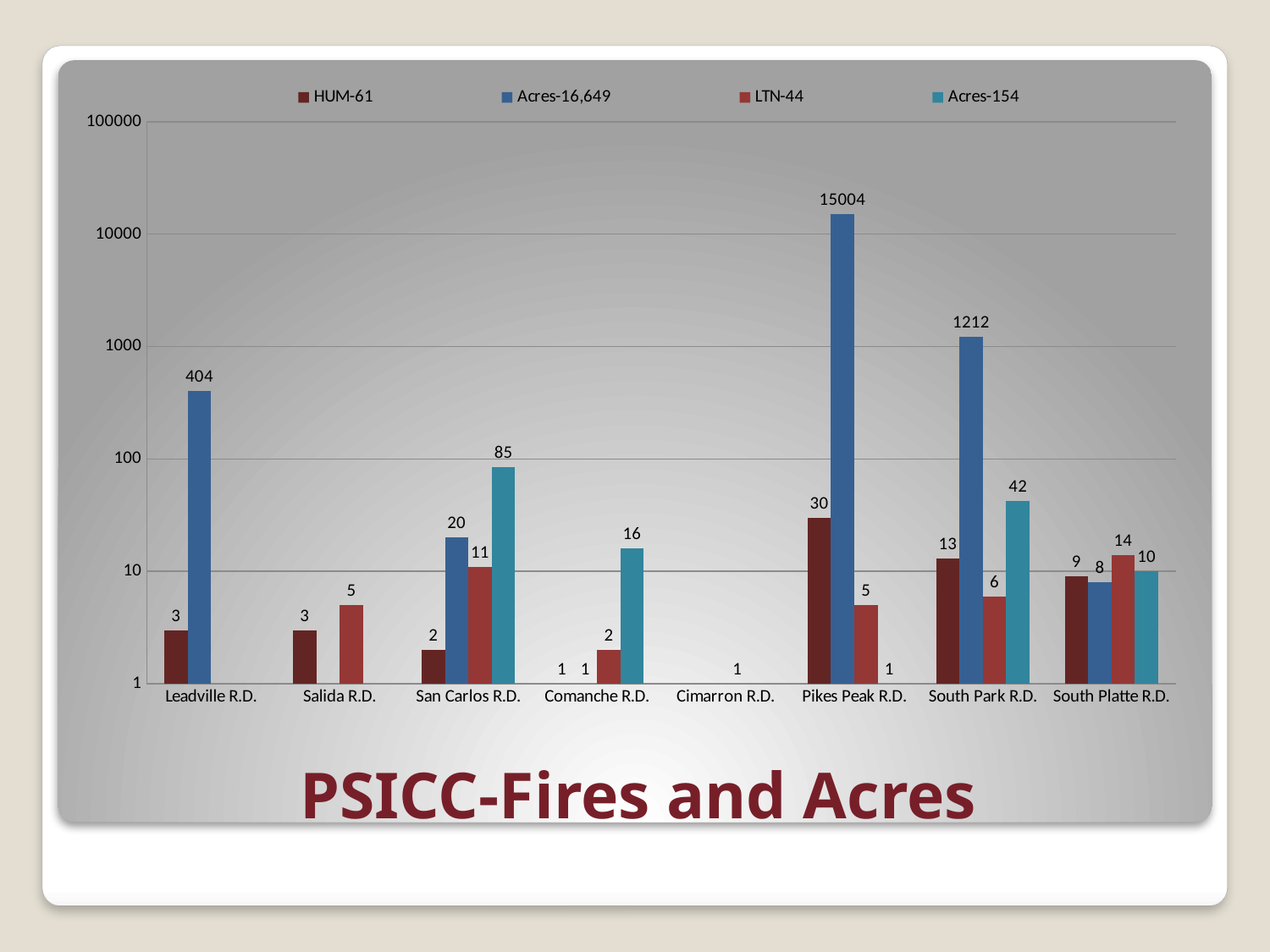
What is the difference between the Acres-154 values for South Park R.D. and Comanche R.D.? 26 What is the value of the Acres-16,649 series for Pikes Peak R.D.? 15004 How many series does the legend list? 4 Which ranger district has the highest HUM-61 value? Pikes Peak R.D. What is the LTN-44 value for Salida R.D.? 5 What is the HUM-61 value for South Park R.D.? 13 How many ranger districts are shown on the x axis? 8 Which has the larger LTN-44 value, San Carlos R.D. or South Platte R.D.? South Platte R.D. What is the difference between the Acres-16,649 values for South Park R.D. and Leadville R.D.? 808 What is the title of the slide's chart? PSICC-Fires and Acres Which ranger district has the highest Acres-16,649 value? Pikes Peak R.D. What is the Acres-154 value for San Carlos R.D.? 85